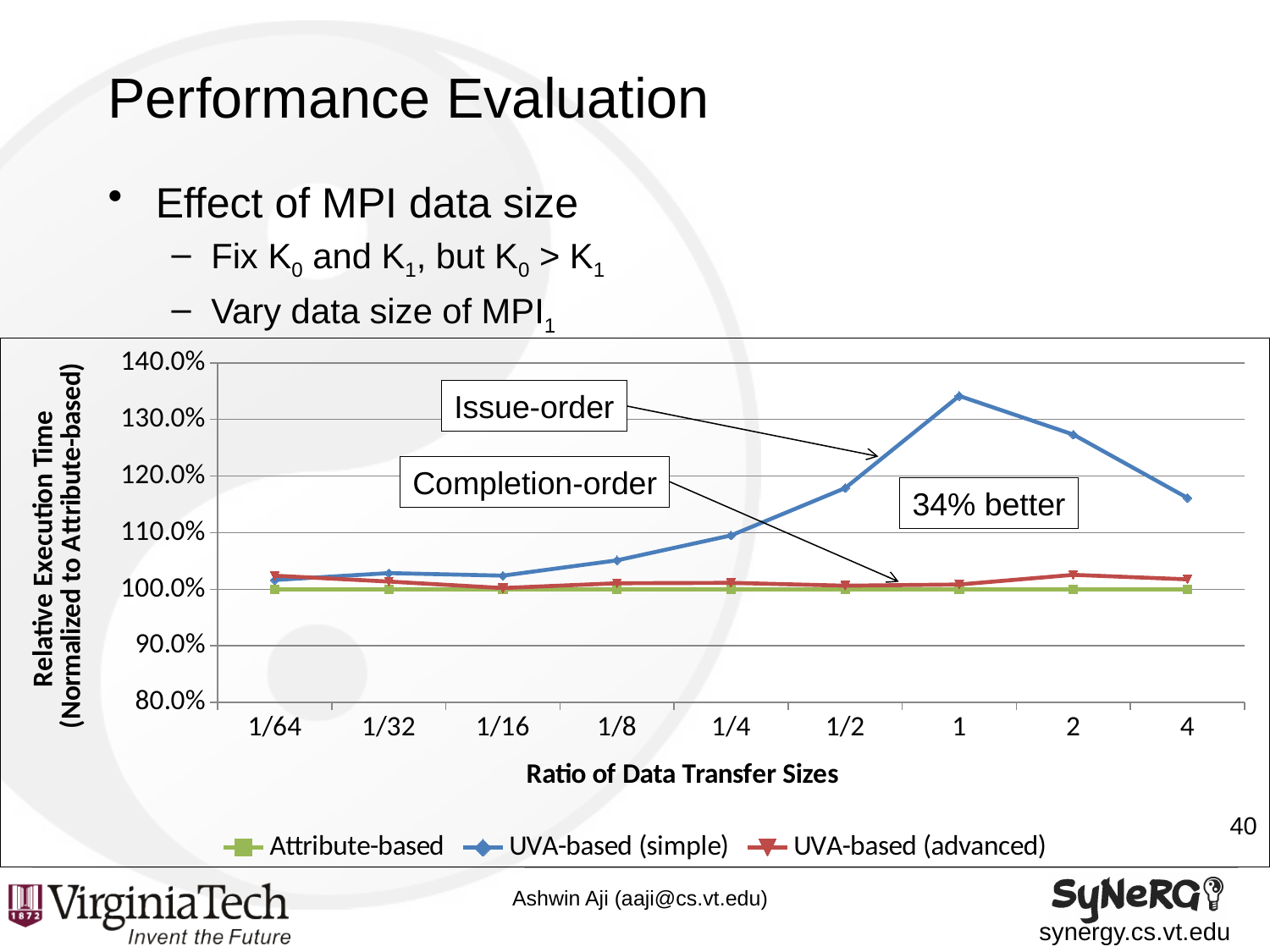
How many series does the chart legend list? 3 Is the value for UVA-based (simple) at a ratio of 4 greater or less than 110.0%? greater What kind of chart is shown on the slide? line chart Does the UVA-based (simple) series rise or fall from a ratio of 1 to a ratio of 4? fall How many ratio values are shown along the x axis of the chart? 9 What is the value of the Attribute-based series at a ratio of 1/8? 100.0% Is the value for UVA-based (simple) at a ratio of 1 greater or less than 130.0%? greater What is the title of the x axis of the chart? Ratio of Data Transfer Sizes Is the value for UVA-based (advanced) at a ratio of 1 greater or less than 110.0%? less At which ratio does the UVA-based (simple) series reach its highest value? 1 At a ratio of 1, which series has the larger value: UVA-based (simple) or UVA-based (advanced)? UVA-based (simple) What improvement does the annotation on the chart claim? 34% better